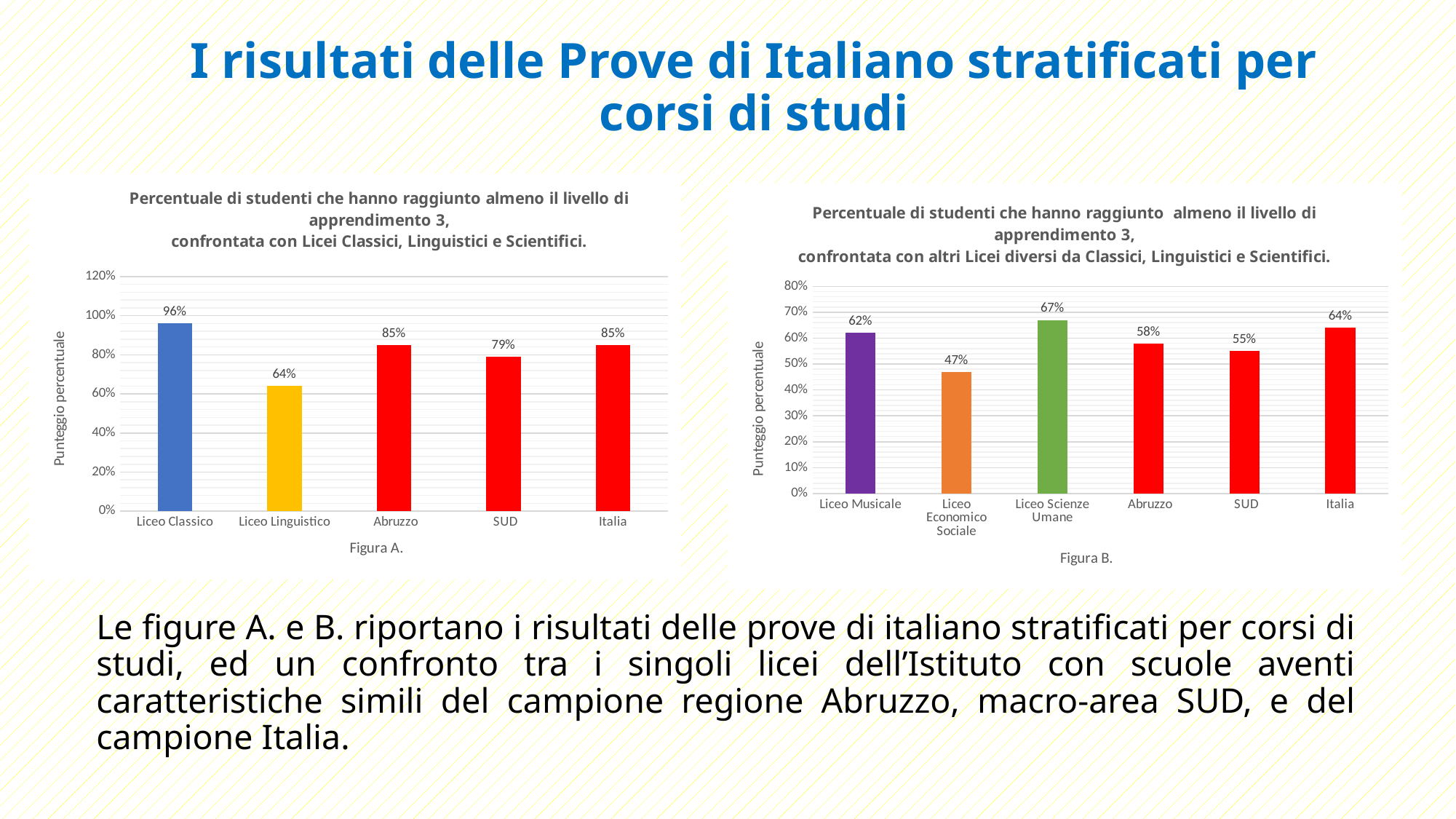
In Figura B (right chart), how many categories are shown on the x axis? 6 In Figura A (left chart), which category has the lowest value? Liceo Linguistico In Figura A (left chart), what is the difference between Liceo Classico and SUD? 17% In Figura A (left chart), how many categories are shown on the x axis? 5 In Figura B (right chart), what is the value for Liceo Economico Sociale? 47% In Figura B (right chart), what colour is the bar for Liceo Musicale? Purple In Figura B (right chart), which is larger, Liceo Musicale or Italia? Italia In Figura A (left chart), what is the value for Liceo Linguistico? 64% In Figura B (right chart), which category has the highest value? Liceo Scienze Umane What kind of chart is Figura A (left chart)? Bar chart In Figura B (right chart), what is the difference between Liceo Scienze Umane and Liceo Economico Sociale? 20% In Figura A (left chart), what is the value for Liceo Classico? 96%